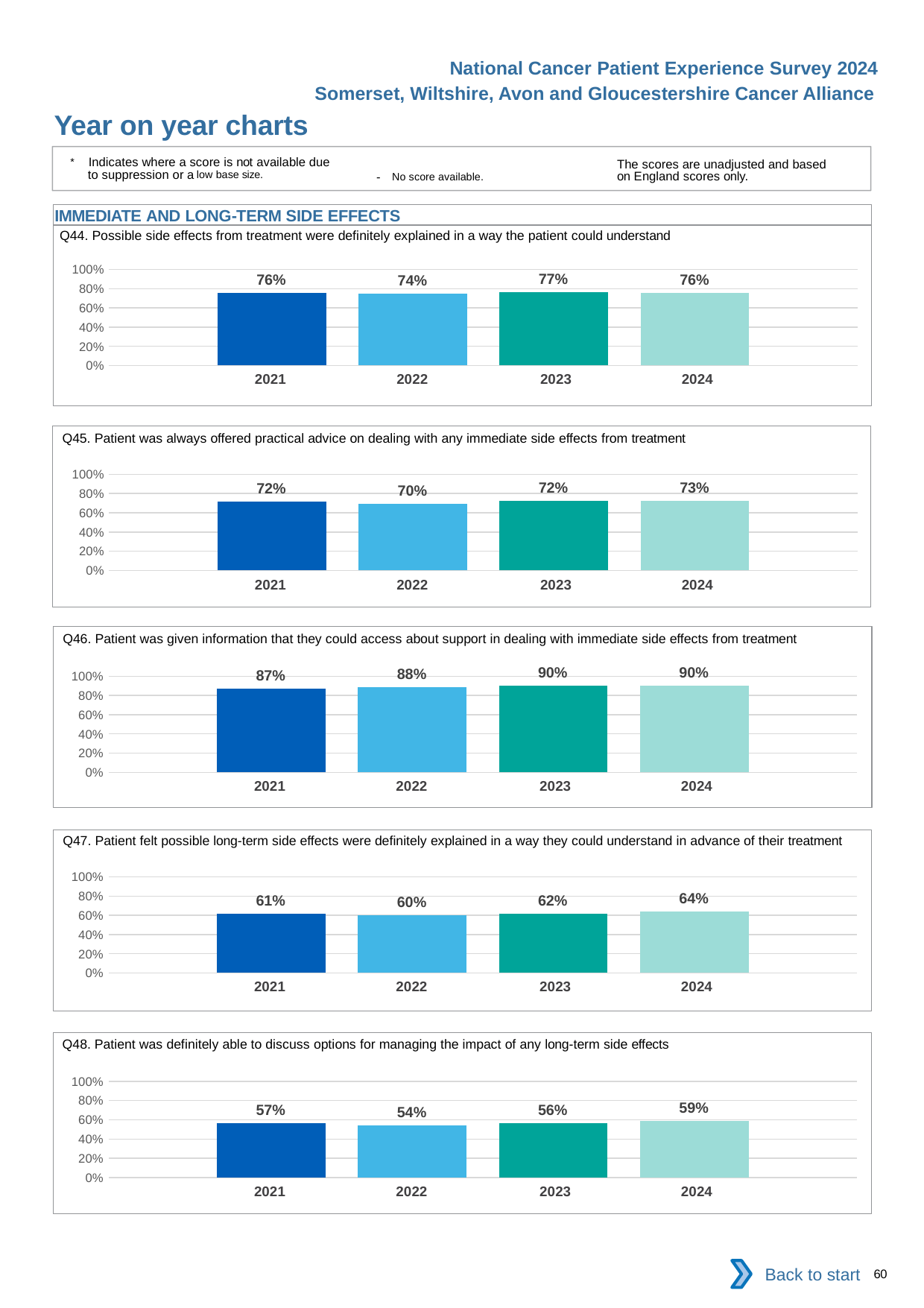
In the Q44 chart, what is the value for 2023? 77% What kind of chart is used for Q46? bar chart In the Q45 chart, which year has the lowest value? 2022 In the Q48 chart, is the value for 2021 larger or smaller than the value for 2024? smaller In the Q46 chart, do the values rise or fall from 2021 to 2024? rise In the Q47 chart, which year has the highest value? 2024 In the Q46 chart, what is the difference between the 2024 value and the 2021 value? 3% How many years are shown in the Q45 chart? 4 In the Q44 chart, what is the difference between the 2023 value and the 2022 value? 3% In the Q47 chart, is the value for 2024 greater or less than 80%? less In the Q48 chart, what is the value for 2022? 54% What is the section heading above the Q44 chart? IMMEDIATE AND LONG-TERM SIDE EFFECTS